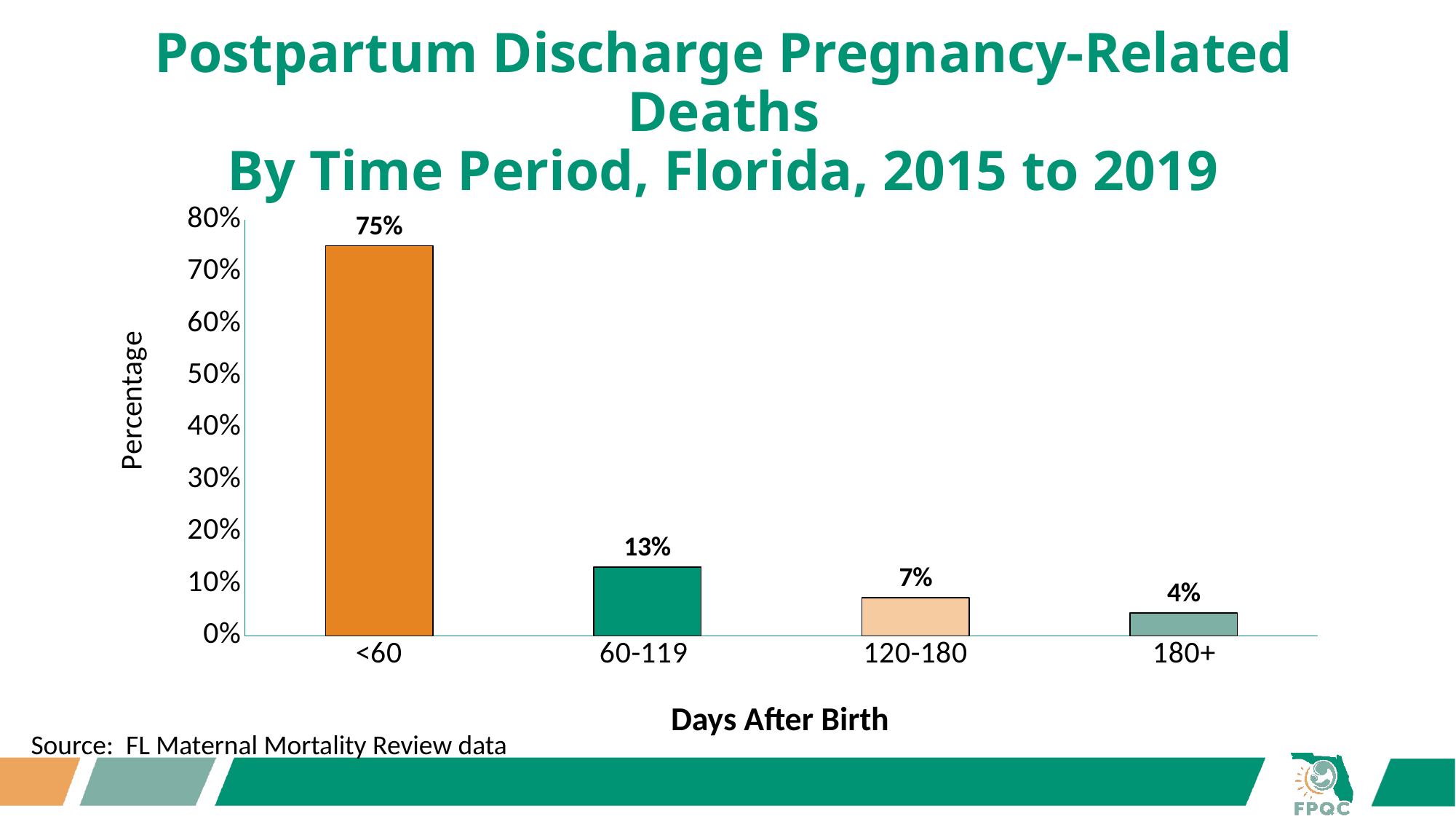
What kind of chart is shown on the slide? bar chart Which is larger, the value for 120-180 or the value for 180+? 120-180 What is the value for the 60-119 days after birth category? 13% What is the value for the 120-180 days after birth category? 7% What percentage of postpartum discharge pregnancy-related deaths occurred at <60 days after birth? 75% How many time period categories are shown on the x axis? 4 Which time period has the lowest percentage of deaths? 180+ What is the value for the 180+ days after birth category? 4% What is the difference between the <60 and 60-119 categories? 62% Do the values rise or fall moving from left to right along the x axis? fall Which time period has the highest percentage of deaths? <60 Is the value for <60 greater or less than 70%? greater